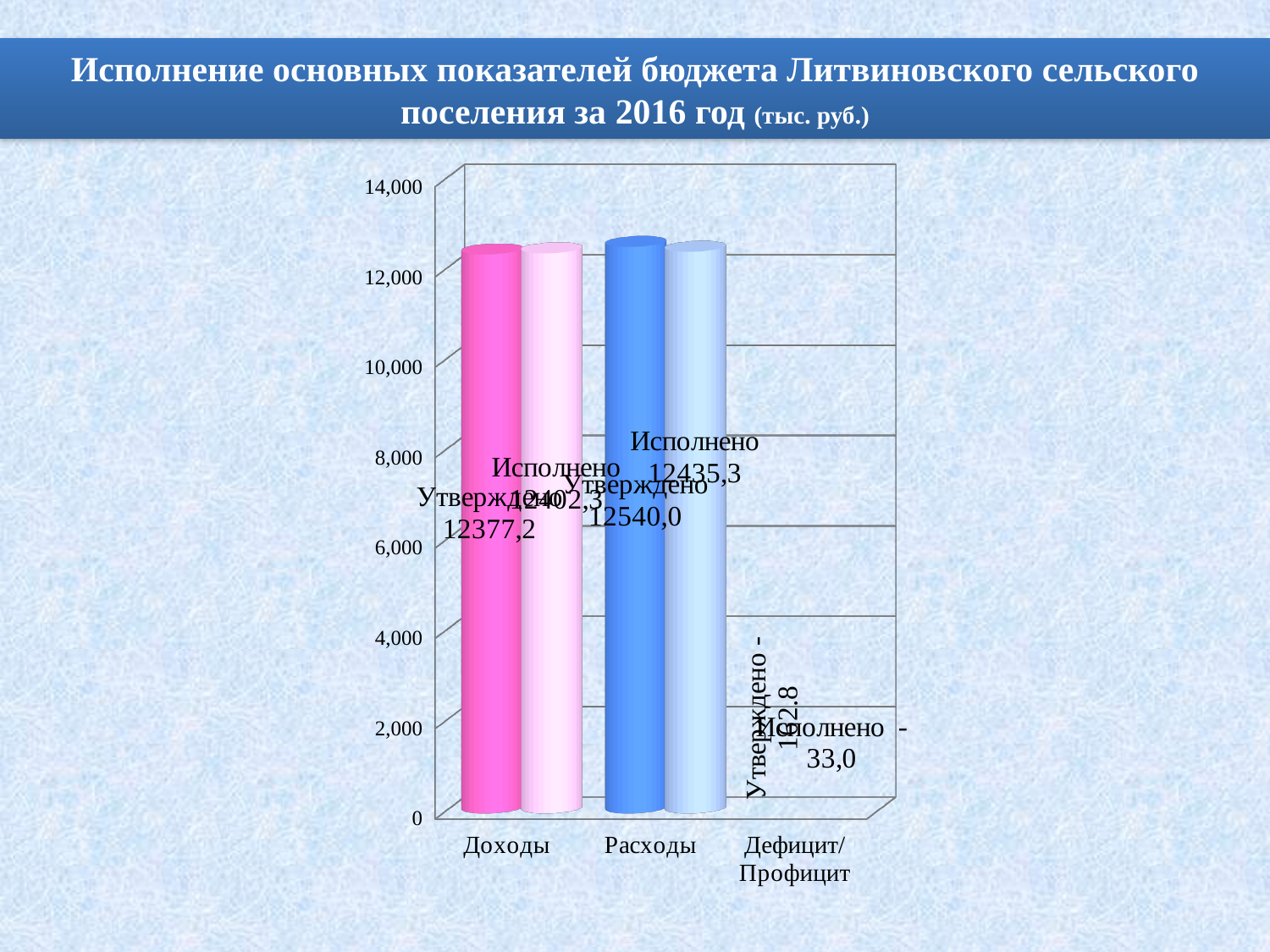
Is the executed (Исполнено) value for Расходы greater or less than 14,000? less What is the executed (Исполнено) value for Дефицит/Профицит? -33,0 What is the approved (Утверждено) value for Доходы? 12377,2 Which year does the chart on the slide cover? 2016 What is the approved (Утверждено) value for Расходы? 12540,0 How many categories are shown on the x axis of the chart? 3 In what units are the values on the chart expressed, according to the slide title? тыс. руб. What kind of chart is shown on the slide? bar chart For Расходы, which is larger: the approved (Утверждено) value or the executed (Исполнено) value? Утверждено Is the approved (Утверждено) value for Доходы greater or less than 12,000? greater What is the difference between the approved and executed values for Расходы? 104,7 What is the executed (Исполнено) value for Расходы? 12435,3